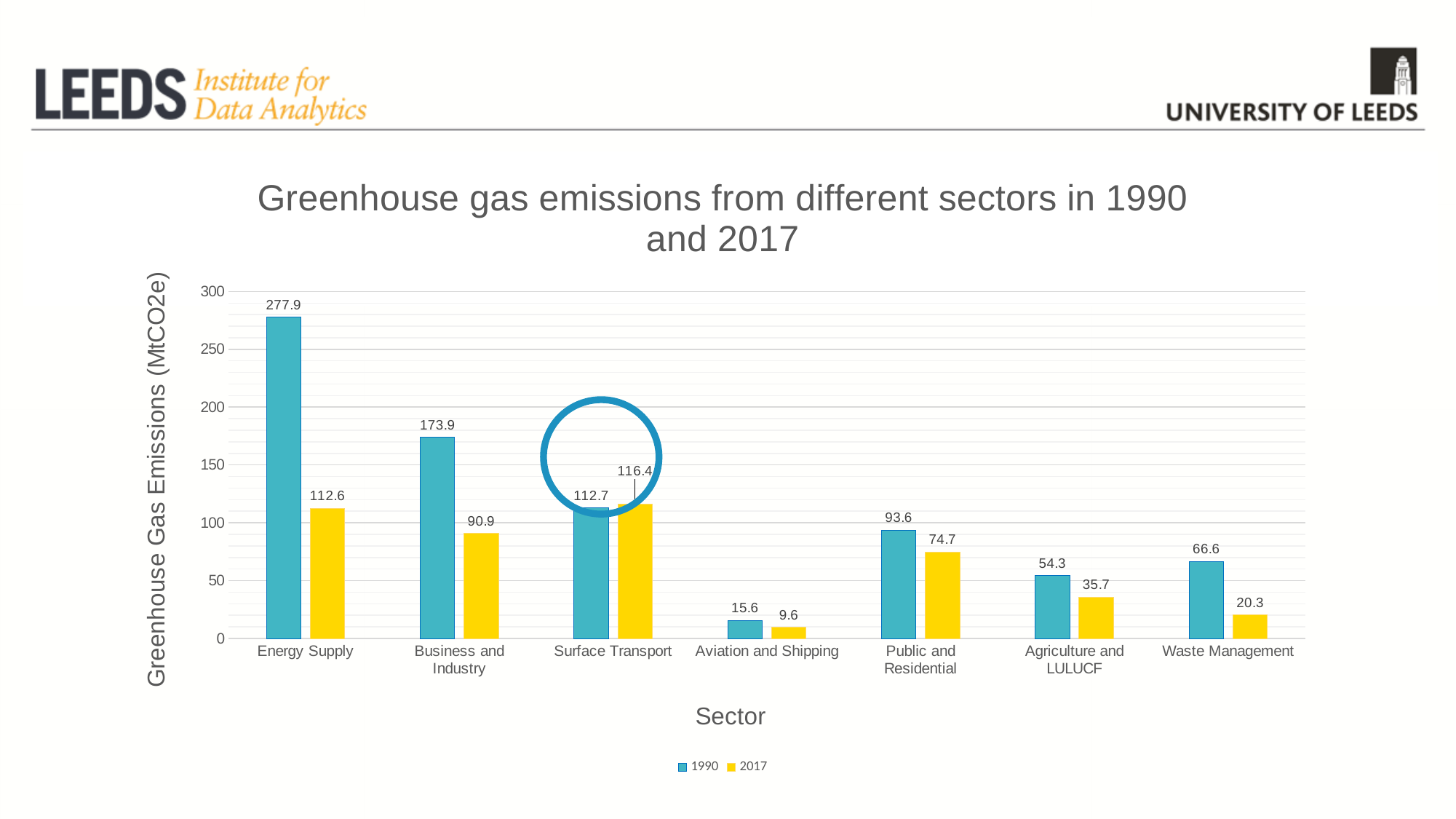
What was the greenhouse gas emissions value for Surface Transport in 2017? 116.4 Is the 1990 value for Business and Industry greater or less than 150? greater How many sectors are shown on the x axis? 7 What is the difference between the 1990 and 2017 emissions for Energy Supply? 165.3 What kind of chart is shown on the slide? Bar chart What was the greenhouse gas emissions value for Waste Management in 2017? 20.3 How many series does the legend list? 2 What is the label of the y axis? Greenhouse Gas Emissions (MtCO2e) Which sector had the highest greenhouse gas emissions in 1990? Energy Supply For Surface Transport, which year had higher emissions, 1990 or 2017? 2017 Which sector had the lowest greenhouse gas emissions in 2017? Aviation and Shipping What was the greenhouse gas emissions value for Energy Supply in 1990? 277.9